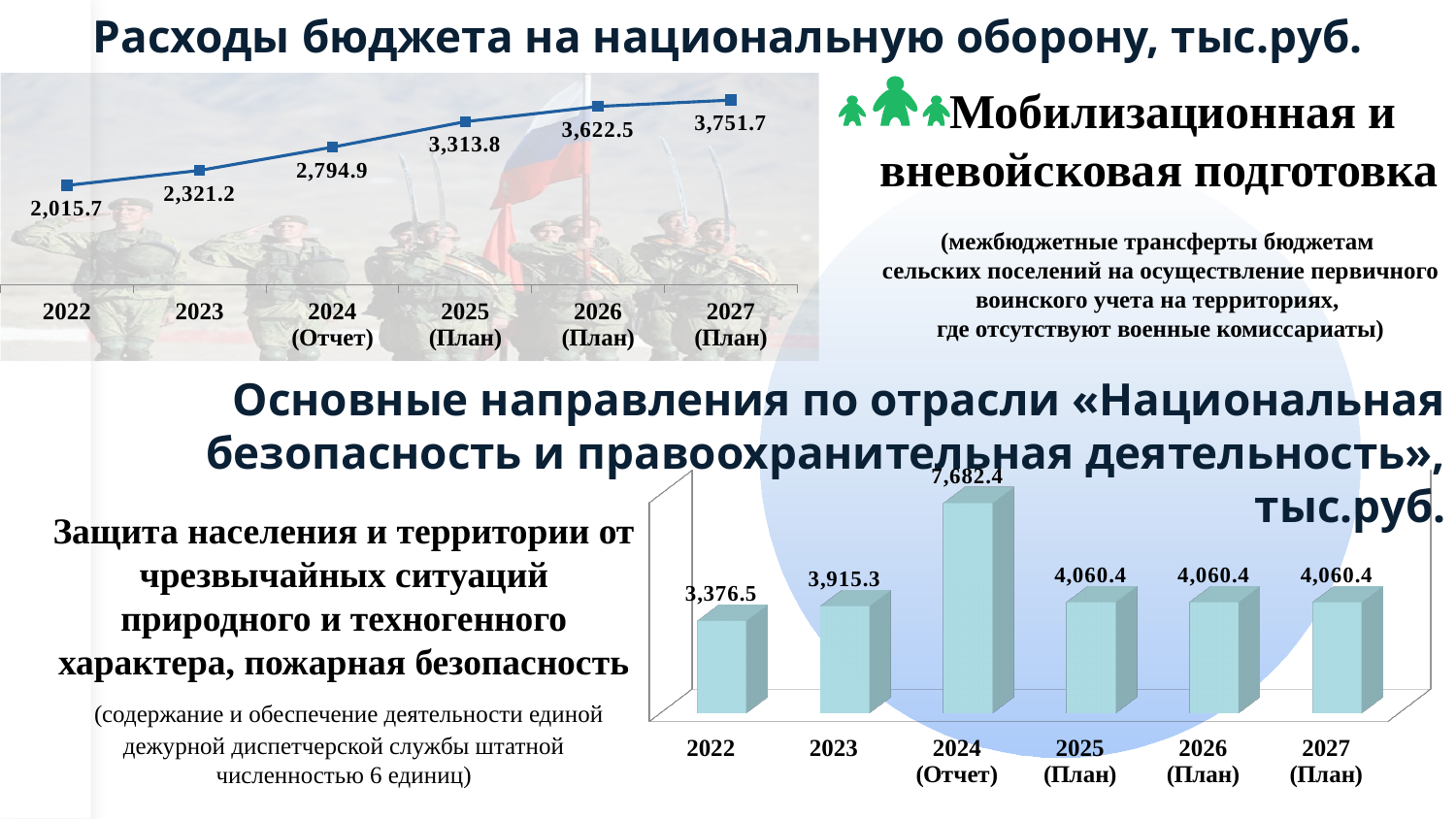
What kind of chart is the top chart on national defence expenditure? line chart In the bottom bar chart on national security and law enforcement, what is the value for 2024 (Отчет)? 7,682.4 In the bottom bar chart on national security and law enforcement, what is the value for 2022? 3,376.5 In the top line chart on national defence expenditure, what is the value for 2025 (План)? 3,313.8 In the bottom bar chart on national security and law enforcement, which year has the highest value? 2024 (Отчет) In the top line chart on national defence expenditure, what is the value for 2022? 2,015.7 How many years are shown in the bottom bar chart on national security and law enforcement? 6 In the top line chart on national defence expenditure, which year has the highest value? 2027 (План) In the top line chart on national defence expenditure, do the values rise or fall from 2022 to 2027? rise In the top line chart on national defence expenditure, which year has the lowest value? 2022 In the bottom bar chart on national security and law enforcement, what is the difference between the 2023 and 2022 values? 538.8 In the top line chart on national defence expenditure, what is the difference between the 2027 (План) and 2026 (План) values? 129.2